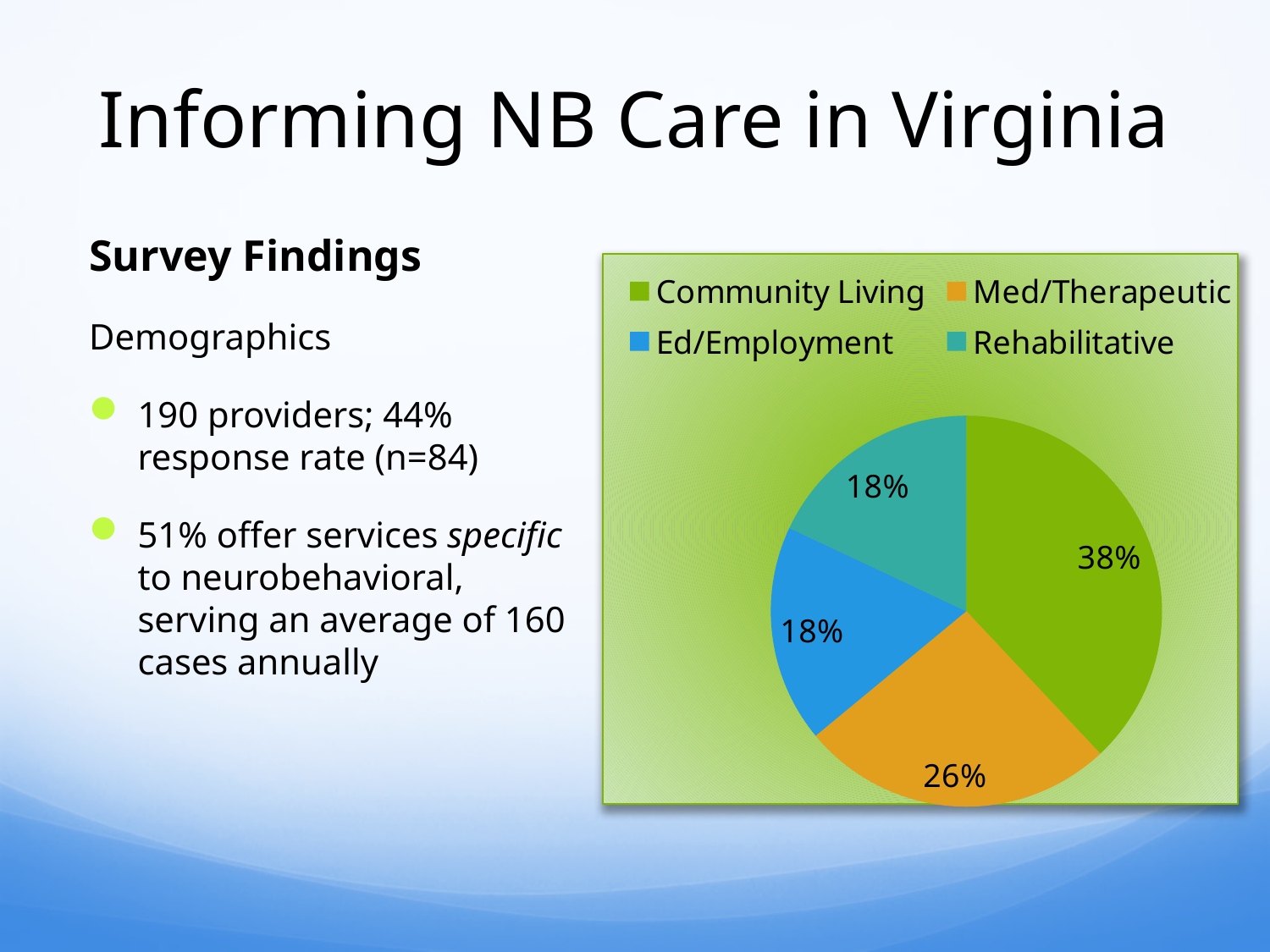
What share of the pie does Ed/Employment represent? 18% What share of the pie does Rehabilitative represent? 18% How many entries does the legend list? 4 Which category has the largest slice of the pie? Community Living Which is larger, the Med/Therapeutic slice or the Rehabilitative slice? Med/Therapeutic What kind of chart is shown on the slide? pie chart How many slices does the pie chart have? 4 What share of the pie does Community Living represent? 38% What share of the pie does Med/Therapeutic represent? 26% What is the difference in percentage points between Med/Therapeutic and Ed/Employment? 8 What is the difference in percentage points between Community Living and Med/Therapeutic? 12 What colour is the Community Living slice in the pie chart? green